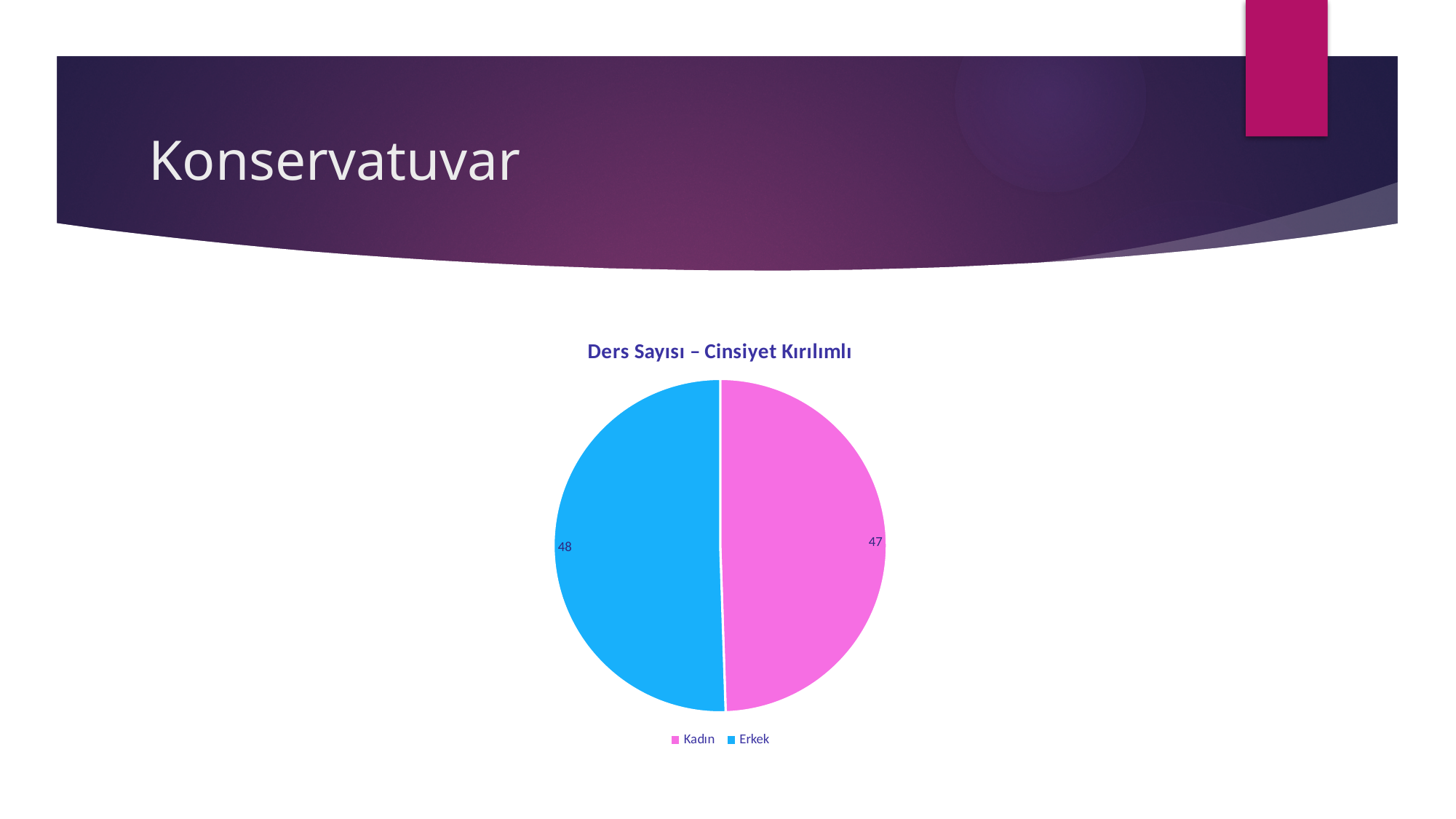
Which category has the largest value in the pie chart? Erkek Which category has the smallest value in the pie chart? Kadın Which category has the larger value, Kadın or Erkek? Erkek Which colour represents Erkek in the pie chart? blue What type of chart is shown on the slide? pie chart How many slices does the pie chart have? 2 What is the total of the two values shown in the pie chart? 95 What is the difference between the values for Erkek and Kadın? 1 What is the value for Erkek in the pie chart? 48 How many entries does the legend list? 2 What is the title of the chart? Ders Sayısı – Cinsiyet Kırılımlı What is the value for Kadın in the pie chart? 47